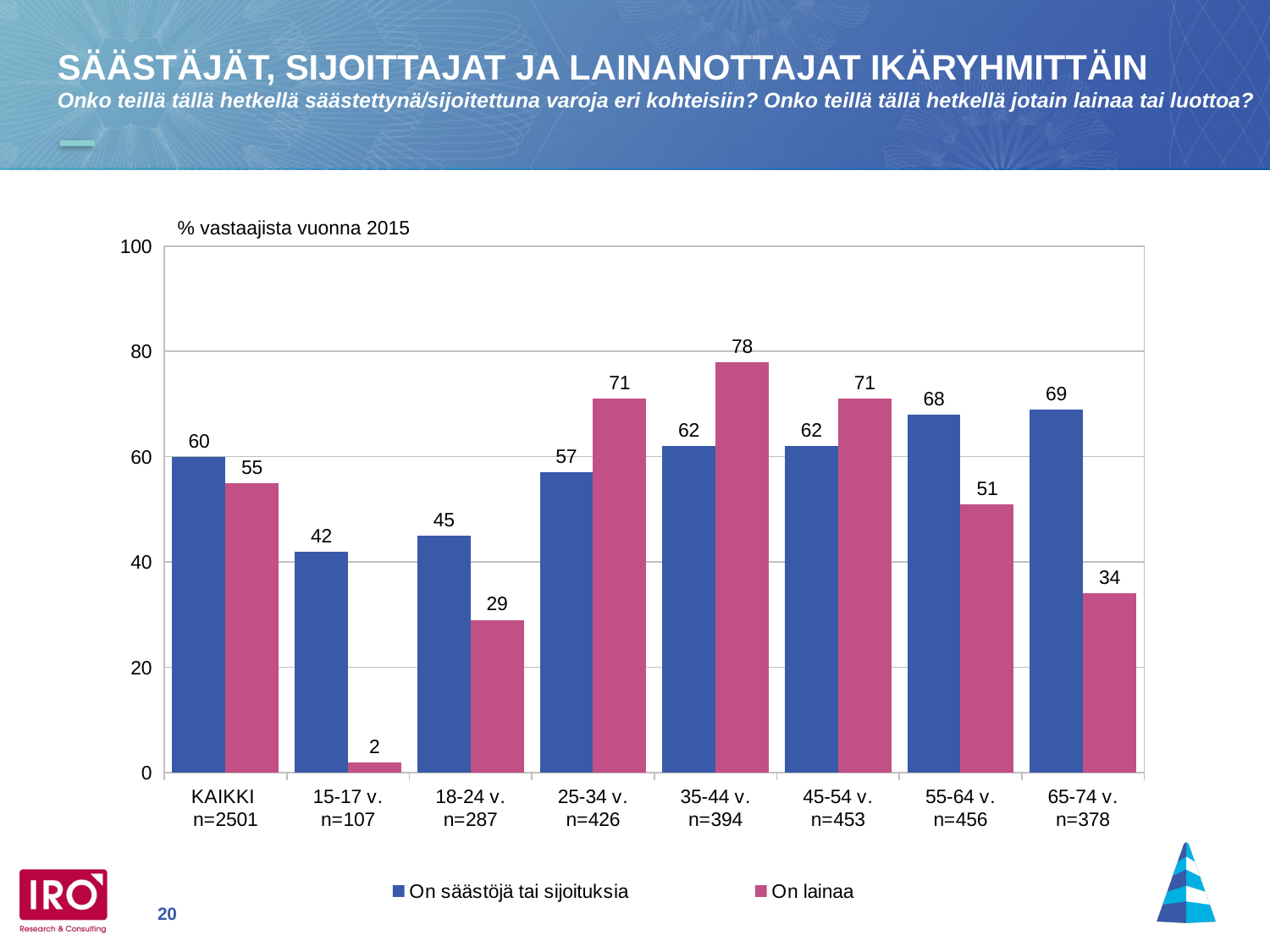
What is the value for "On lainaa" for KAIKKI? 55 What is the difference between "On lainaa" and "On säästöjä tai sijoituksia" in the 25-34 v. age group? 14 What is the sample size (n) shown for the 45-54 v. age group? n=453 Is the value for "On lainaa" in the 55-64 v. age group greater or less than 60? less How many series does the legend list? 2 What kind of chart is shown on the slide? bar chart Which age group has the lowest value for "On lainaa"? 15-17 v. How many categories are shown on the x axis? 8 What is the value for "On lainaa" in the 35-44 v. age group? 78 In the 65-74 v. age group, which is larger: "On säästöjä tai sijoituksia" or "On lainaa"? On säästöjä tai sijoituksia What is the value for "On säästöjä tai sijoituksia" in the 18-24 v. age group? 45 Which age group has the highest value for "On säästöjä tai sijoituksia"? 65-74 v.